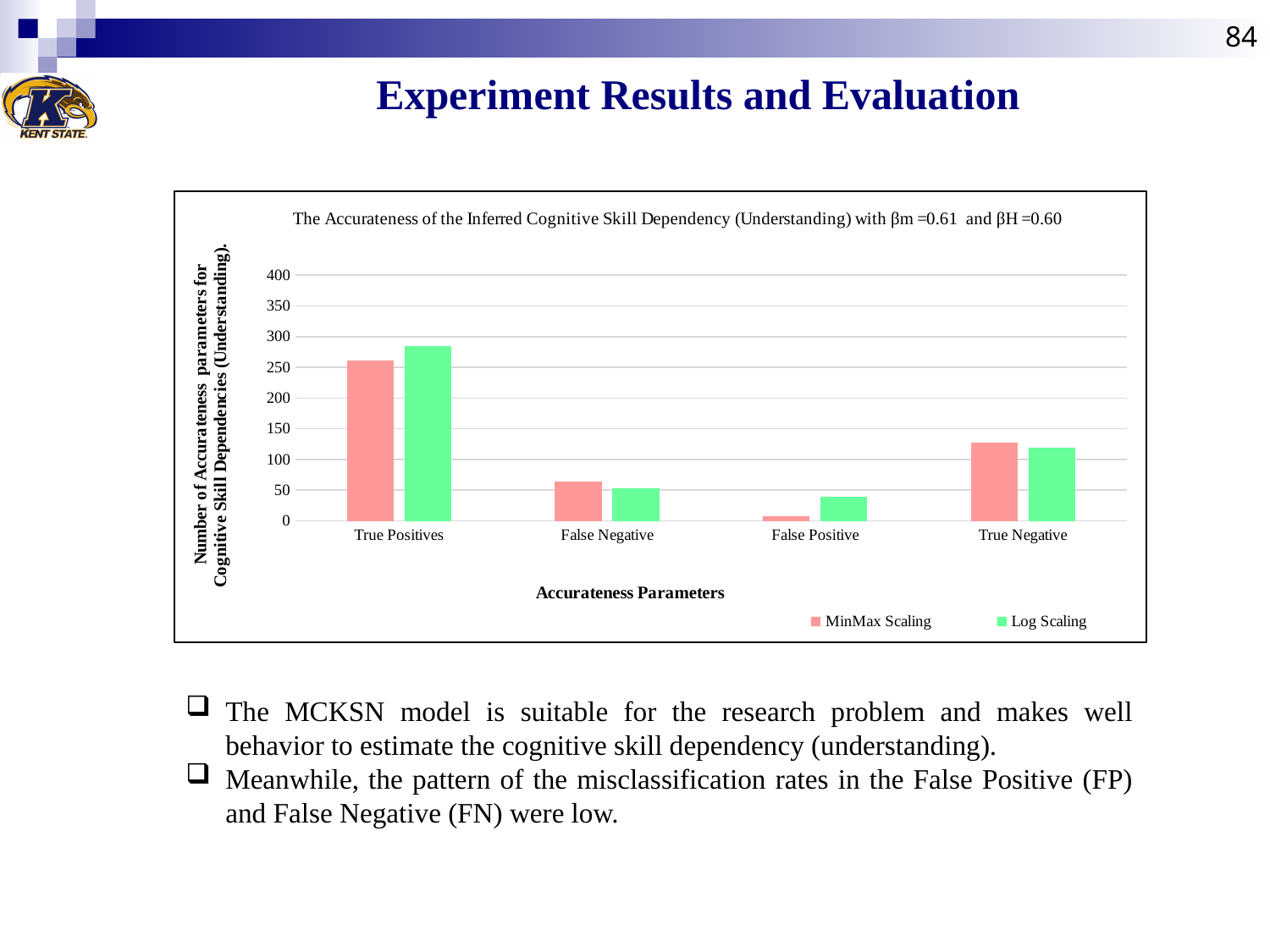
How many categories are shown on the x axis? 4 Is the Log Scaling value for True Positives greater or less than 250? greater For False Positive, which series has the larger value, MinMax Scaling or Log Scaling? Log Scaling Is the MinMax Scaling value for False Negative greater or less than 100? less Is the MinMax Scaling value for True Negative greater or less than 100? greater How many series does the legend list? 2 Which category has the highest MinMax Scaling value? True Positives Which category has the lowest Log Scaling value? False Positive For True Positives, which series has the larger value, MinMax Scaling or Log Scaling? Log Scaling What kind of chart is shown on the slide? bar chart What is the label of the x axis? Accurateness Parameters Which category has the lowest MinMax Scaling value? False Positive